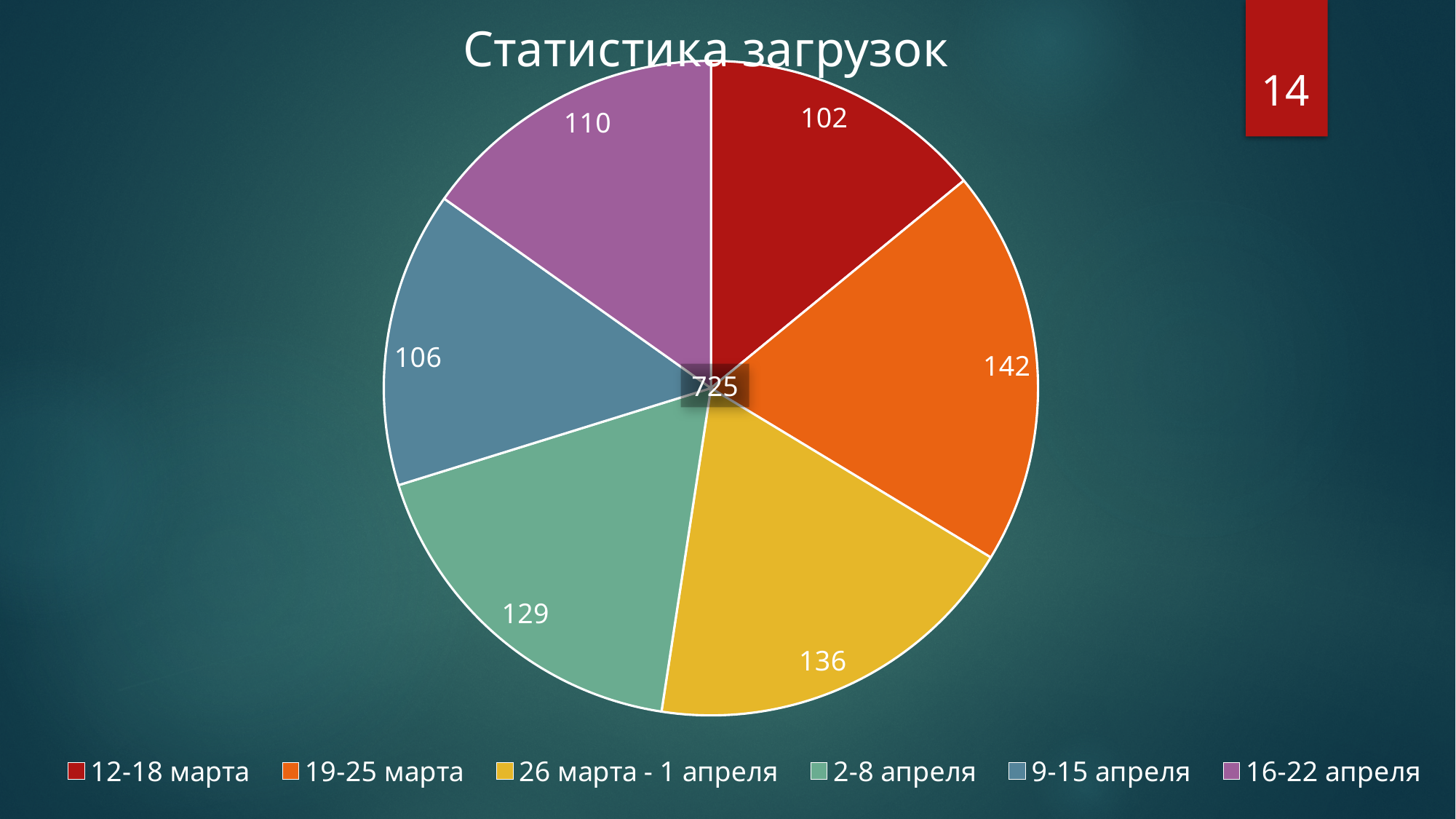
What is the value for 2-8 апреля? 129 Which category has the smallest slice? 12-18 марта What is the difference between the values for 19-25 марта and 9-15 апреля? 36 What is the value for 19-25 марта? 142 What is the value for 12-18 марта? 102 What is the total of all slices shown in the centre of the pie? 725 Which is larger, the value for 26 марта - 1 апреля or the value for 2-8 апреля? 26 марта - 1 апреля Which category has the largest slice? 19-25 марта How many slices does the pie chart have? 6 What is the title of the chart? Статистика загрузок What kind of chart is shown on the slide? pie chart What is the value for 16-22 апреля? 110